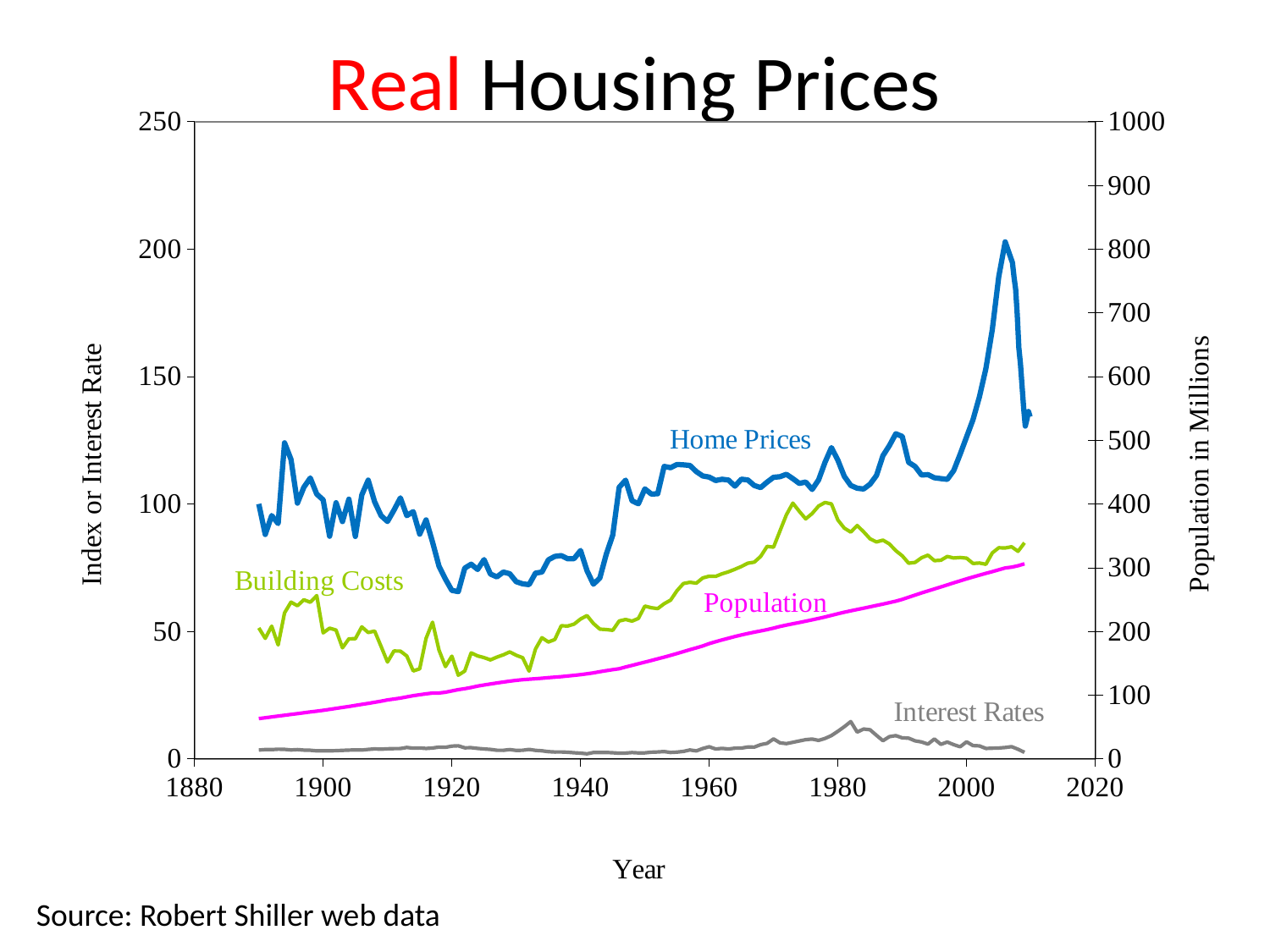
Is the Population value in 1900 greater or less than 100 million? less How many data series are labelled on the chart? 4 Is the peak value of Home Prices around 2006 greater or less than 150? greater What kind of chart is shown on the slide? line chart Which series reaches the highest value on the left axis? Home Prices Is the value of Building Costs at its peak in the 1970s greater or less than 50? greater In 2000, which is higher: Home Prices or Building Costs? Home Prices What is the label of the right-hand vertical axis? Population in Millions Does the Population series rise or fall over the years shown? rise What is the title of the chart? Real Housing Prices Which series stays lowest on the chart across all years? Interest Rates